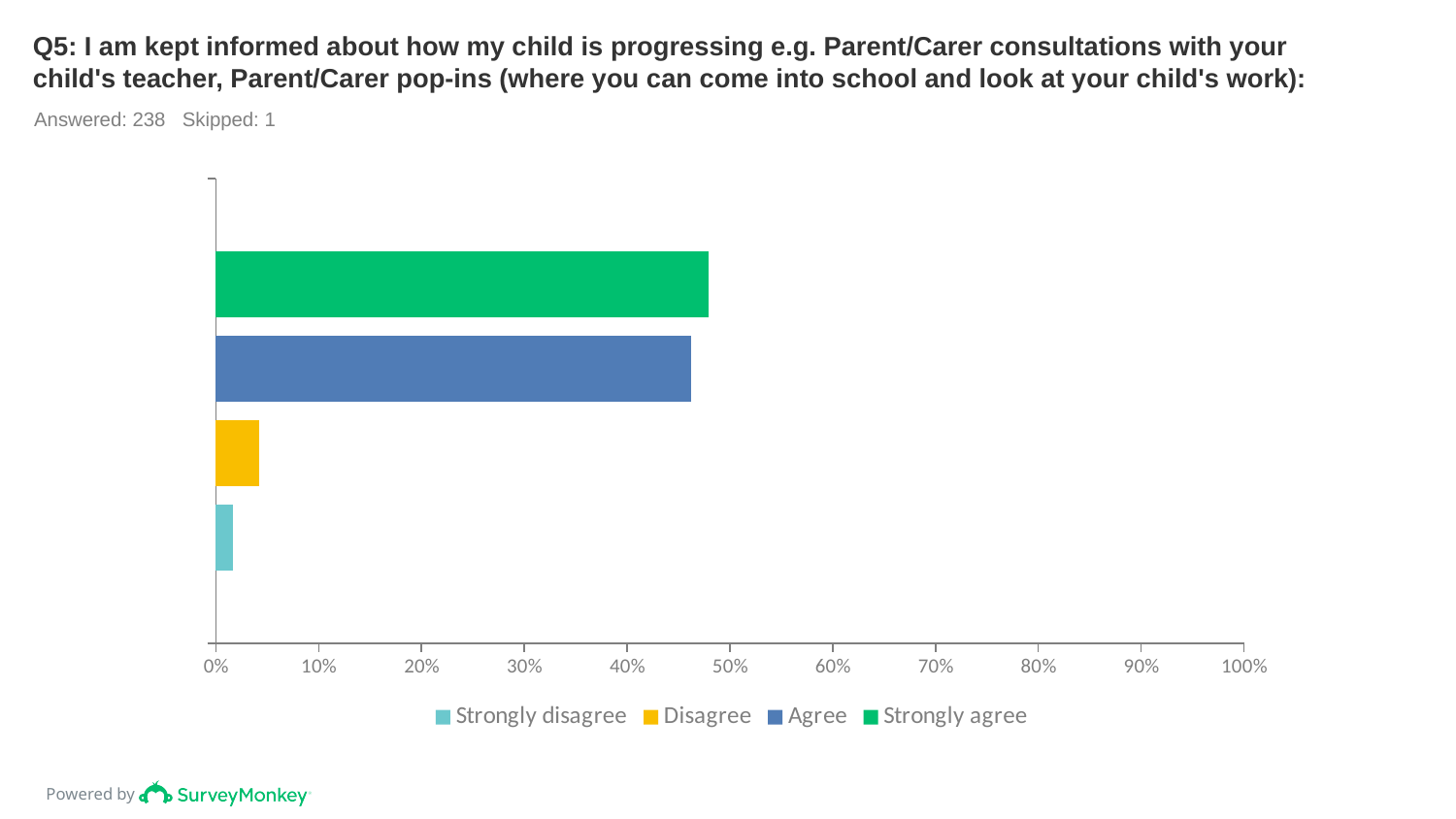
Is the value for Strongly agree greater or less than 40%? greater Which is larger, the value for Disagree or the value for Strongly disagree? Disagree How many entries does the chart legend list? 4 What kind of chart is shown on the slide? bar chart Is the value for Agree greater or less than 50%? less Is the value for Strongly disagree greater or less than 10%? less How many respondents answered this question according to the slide? 238 Which is larger, the value for Agree or the value for Disagree? Agree Which response option has the lowest value in the chart? Strongly disagree Which legend entry is shown in green? Strongly agree How many bars are plotted in the chart? 4